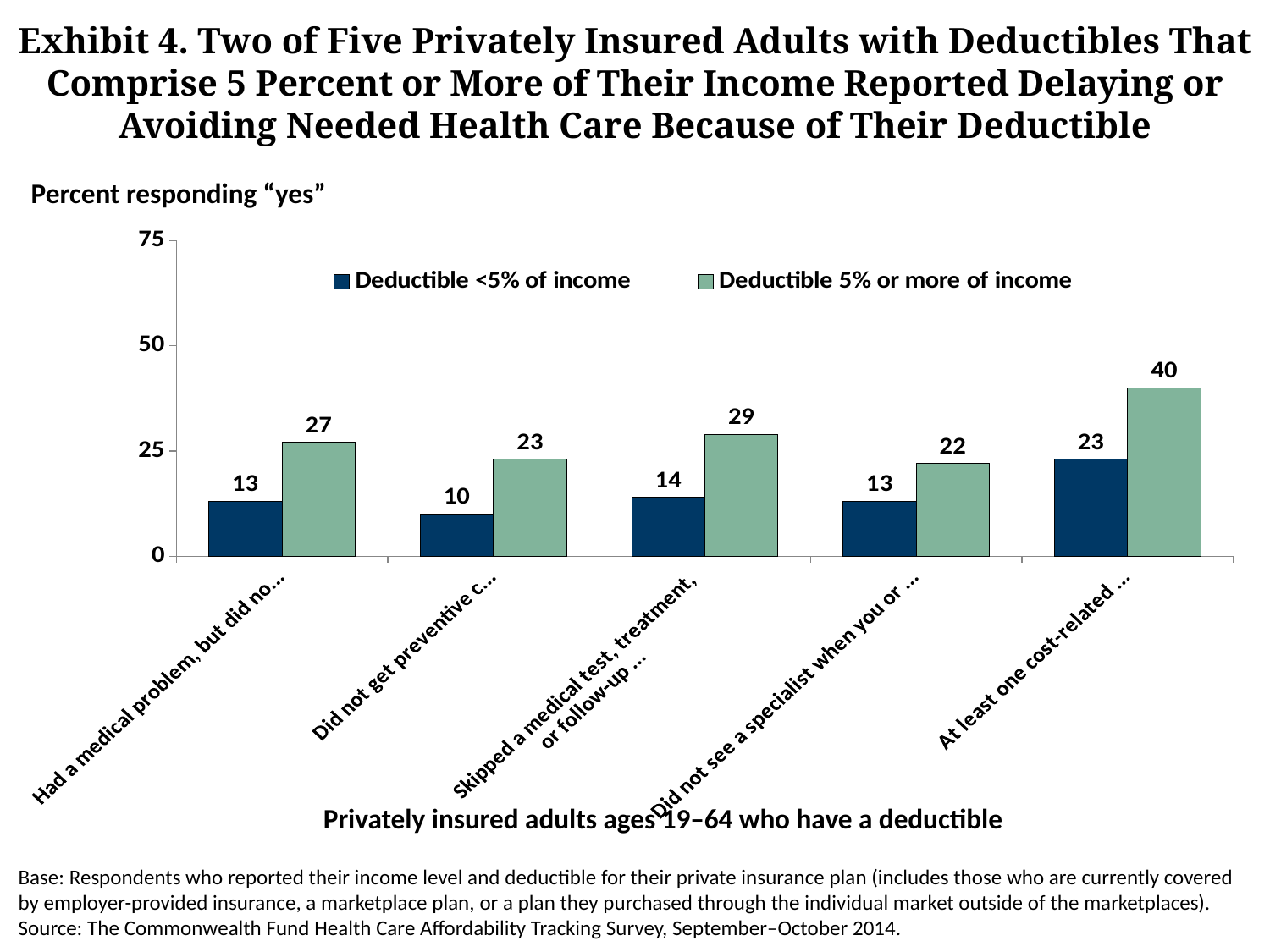
Which category has the highest value for 'Deductible 5% or more of income'? At least one cost-related ... (the last category) Which category has the lowest value for 'Deductible <5% of income'? Did not get preventive c... Is the value for 'Deductible <5% of income' in the first category, 'Had a medical problem, but did no...', greater or less than 25? less What is the value for 'Deductible 5% or more of income' in the last category, 'At least one cost-related ...'? 40 How many categories are plotted along the x axis? 5 In the last category, 'At least one cost-related ...', what is the difference between the 'Deductible 5% or more of income' value and the 'Deductible <5% of income' value? 17 What is the value for 'Deductible 5% or more of income' in the category 'Skipped a medical test, treatment, or follow-up ...'? 29 What kind of chart is shown on the slide? bar chart What is the value for 'Deductible <5% of income' in the category 'Did not get preventive c...'? 10 How many series does the legend list? 2 For 'Deductible 5% or more of income', which is larger: the value for 'Skipped a medical test, treatment, or follow-up ...' or the value for 'Had a medical problem, but did no...'? Skipped a medical test, treatment, or follow-up ... What label appears above the chart describing what the values represent? Percent responding "yes"